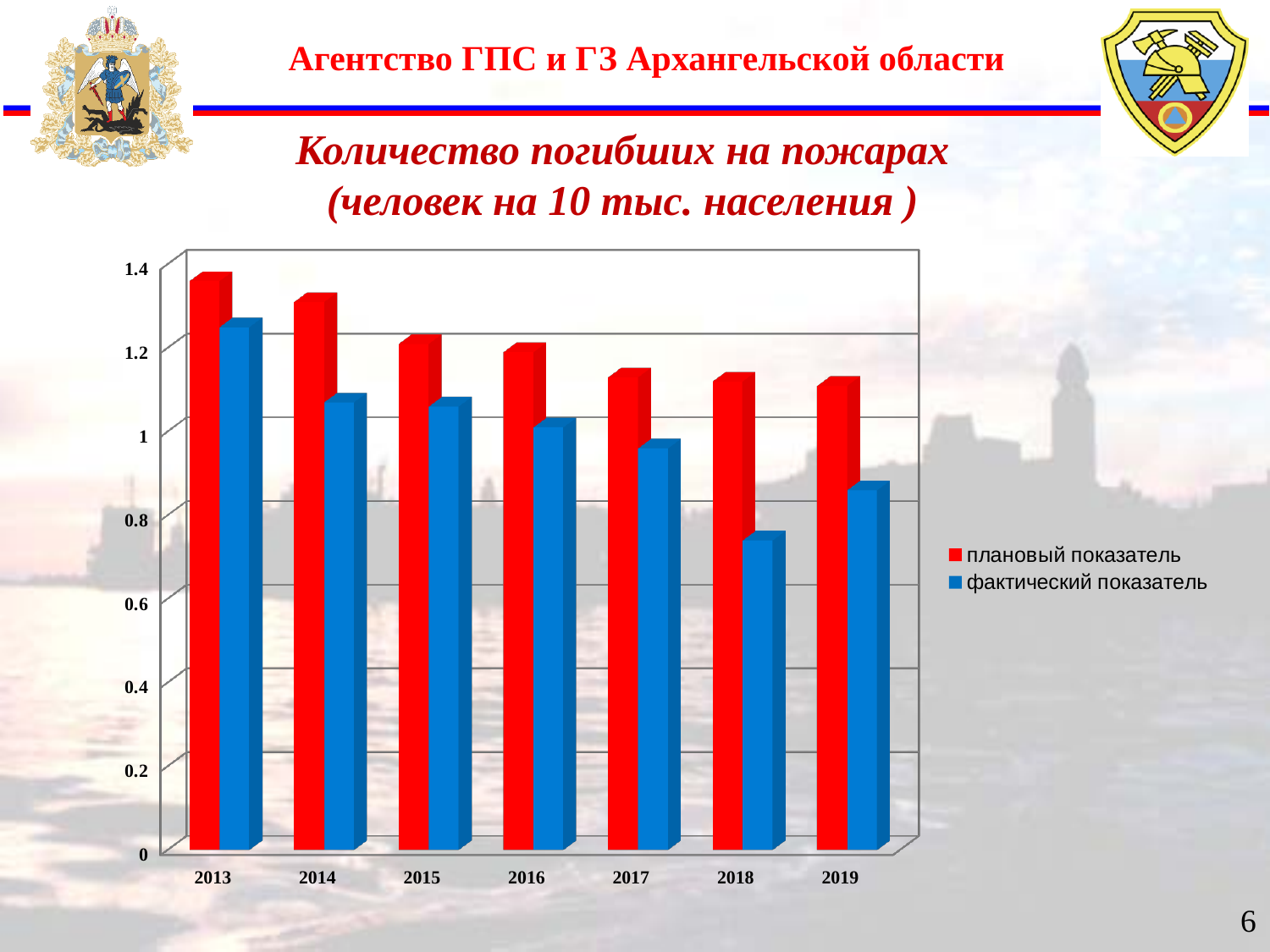
Is the value for фактический показатель in 2019 greater or less than 1? less In 2013, which is larger: плановый показатель or фактический показатель? плановый показатель Which year has the highest value for плановый показатель? 2013 Is the value for плановый показатель in 2013 greater or less than 1.2? greater How many series does the legend list? 2 What kind of chart is shown on the slide? bar chart Which year has the lowest value for фактический показатель? 2018 Does the плановый показатель rise or fall from 2013 to 2019? fall Is the value for фактический показатель in 2018 greater or less than 0.8? less How many years are shown on the x axis? 7 What colour are the bars for плановый показатель? red